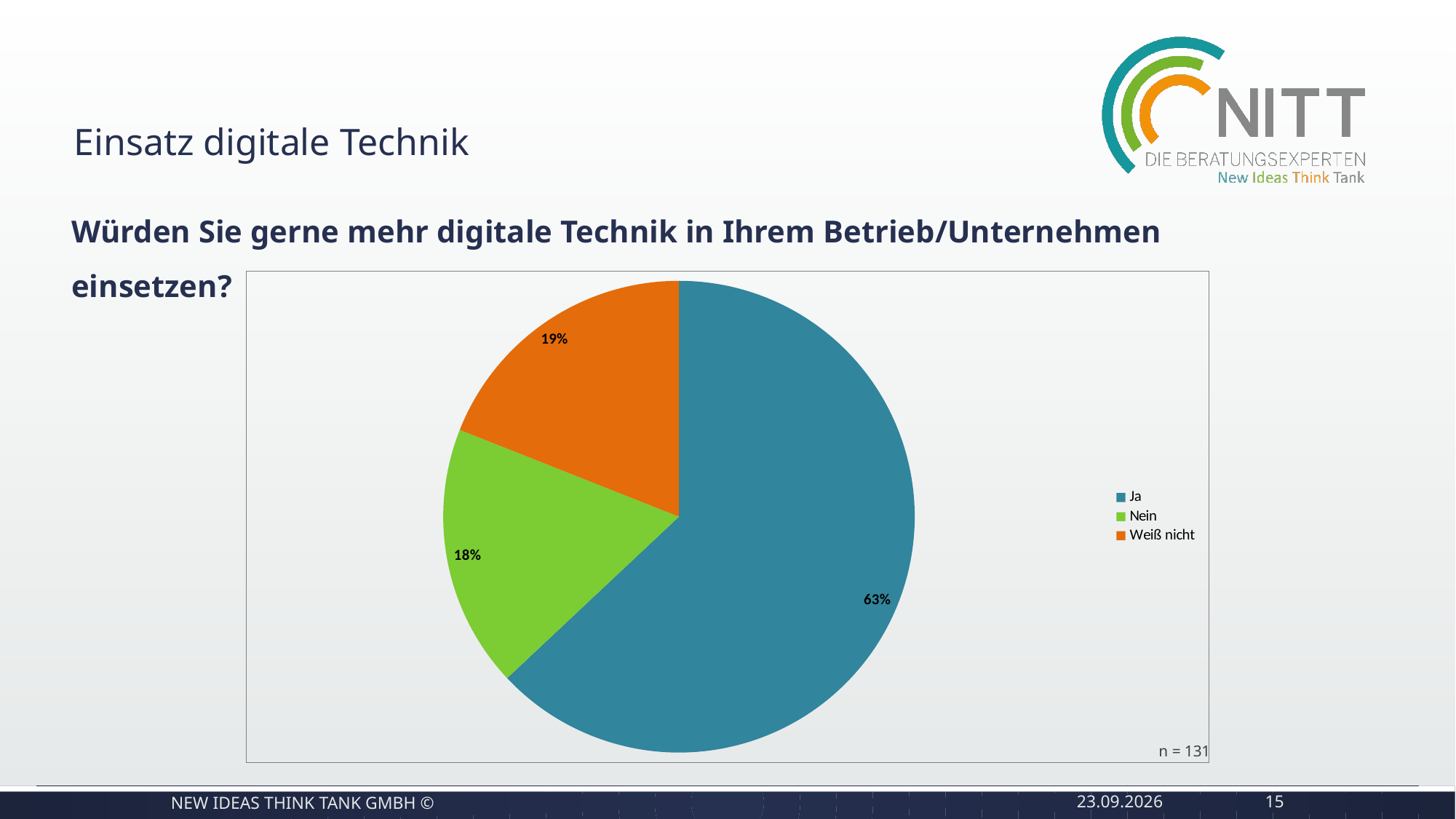
Which answer has the smallest share of the pie? Nein What is the difference in percentage points between the "Weiß nicht" and "Nein" shares? 1 What share of respondents answered "Ja"? 63% Which answer has the largest share of the pie? Ja What share of respondents answered "Nein"? 18% What sample size (n) is shown on the chart? n = 131 How many entries does the legend list? 3 What is the difference in percentage points between the "Ja" and "Nein" shares? 45 Which is larger, the share for "Ja" or the share for "Weiß nicht"? Ja What share of respondents answered "Weiß nicht"? 19% How many slices does the pie chart have? 3 What type of chart is shown on the slide? pie chart